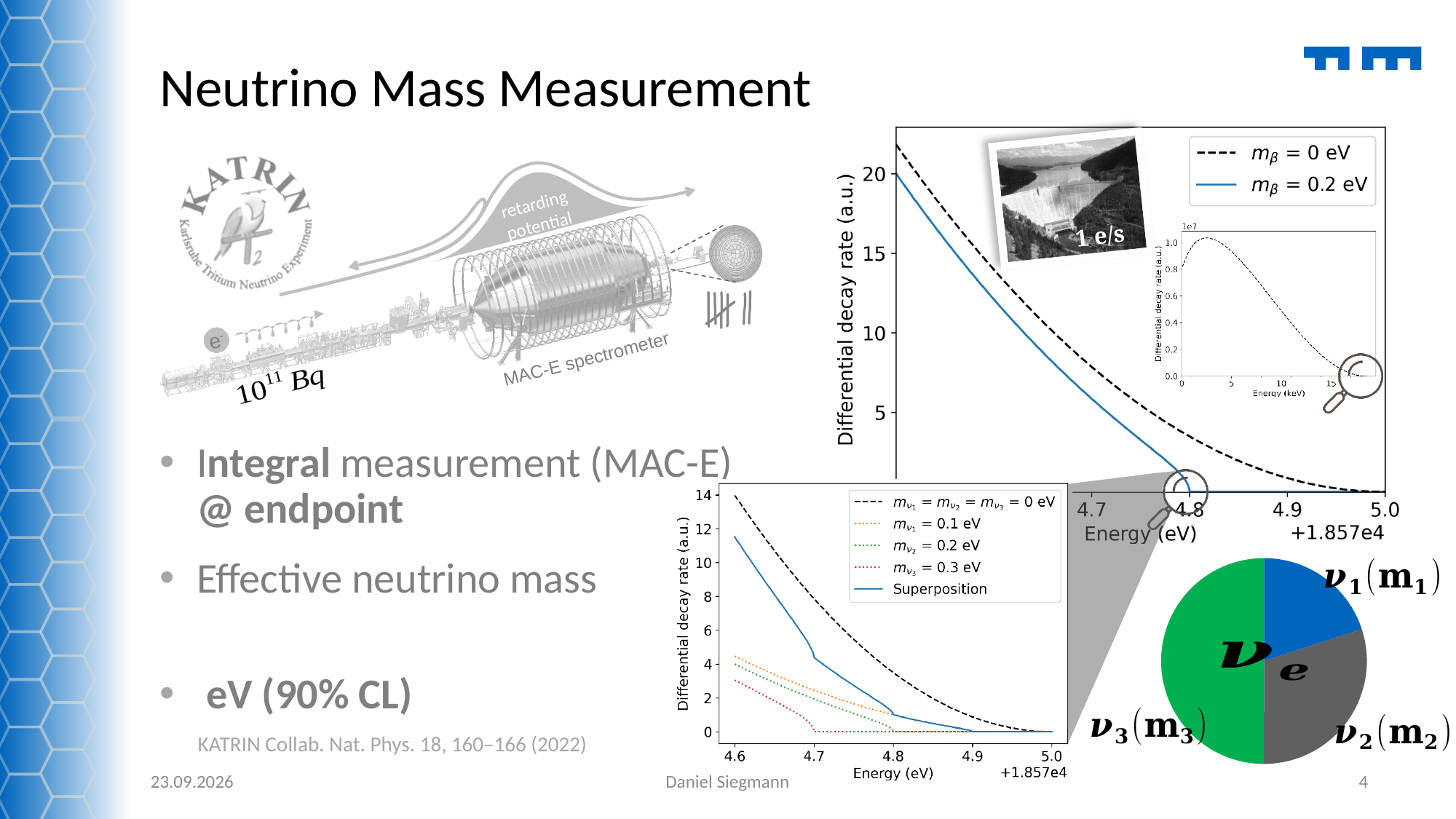
In the lower line chart (bottom centre), at which energy tick does the m_ν3 = 0.3 eV curve reach zero? 4.7 In the large top-right chart, is the value of the m_β = 0 eV curve at energy 4.9 (+1.857e4 eV) greater or less than 5? less In the large top-right chart, is the value of the m_β = 0 eV curve at the left edge of the plot greater or less than 20? greater What is the y-axis label of the large top-right chart? Differential decay rate (a.u.) In the large top-right chart, do the differential decay rate values rise or fall as energy increases? fall How many slices does the pie chart in the bottom right have? 3 How many series does the legend of the large top-right chart list? 2 What kind of chart is the large chart in the top right of the slide? line chart How many series does the legend of the lower line chart (bottom centre) list? 5 In the lower line chart (bottom centre), which series is drawn as a solid blue line? Superposition Which slice of the bottom-right pie chart is the largest? ν3(m3) In the lower line chart (bottom centre), is the Superposition value at energy 4.6 greater or less than 10? greater